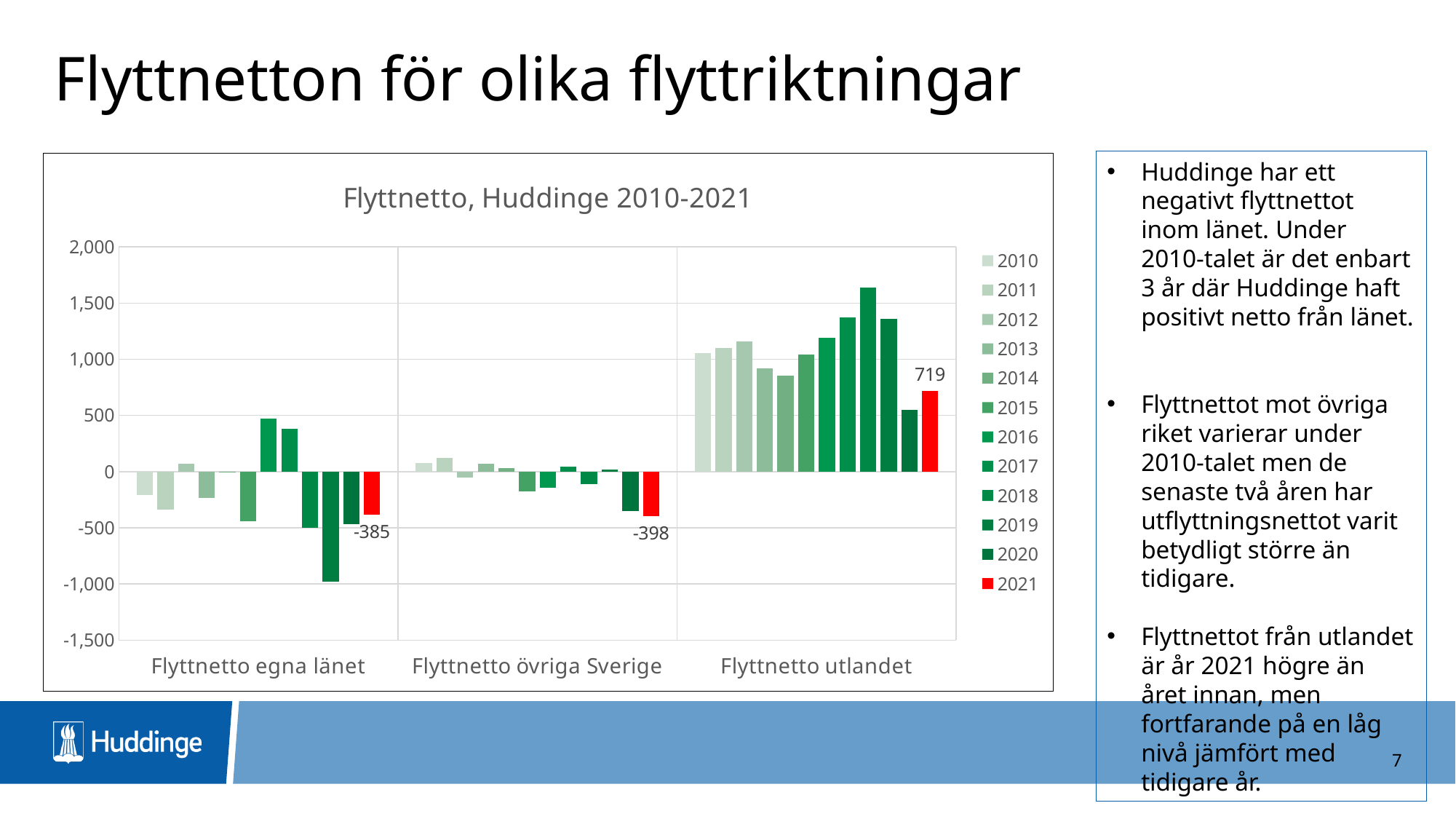
What is the value for 2021 in the category Flyttnetto övriga Sverige? -398 What is the value for 2021 in the category Flyttnetto egna länet? -385 How many series does the legend list? 12 Which year has the lowest value in the category Flyttnetto egna länet? 2019 Which is larger, the 2021 value for Flyttnetto egna länet or the 2021 value for Flyttnetto övriga Sverige? Flyttnetto egna länet How many categories are shown on the x axis? 3 What kind of chart is shown on the slide? bar chart What is the title of the chart? Flyttnetto, Huddinge 2010-2021 What is the value for 2021 in the category Flyttnetto utlandet? 719 Which category has the highest value for 2021? Flyttnetto utlandet What is the difference between the 2021 value for Flyttnetto utlandet and the 2021 value for Flyttnetto egna länet? 1,104 Is the value for 2018 in Flyttnetto utlandet greater or less than 1,500? greater